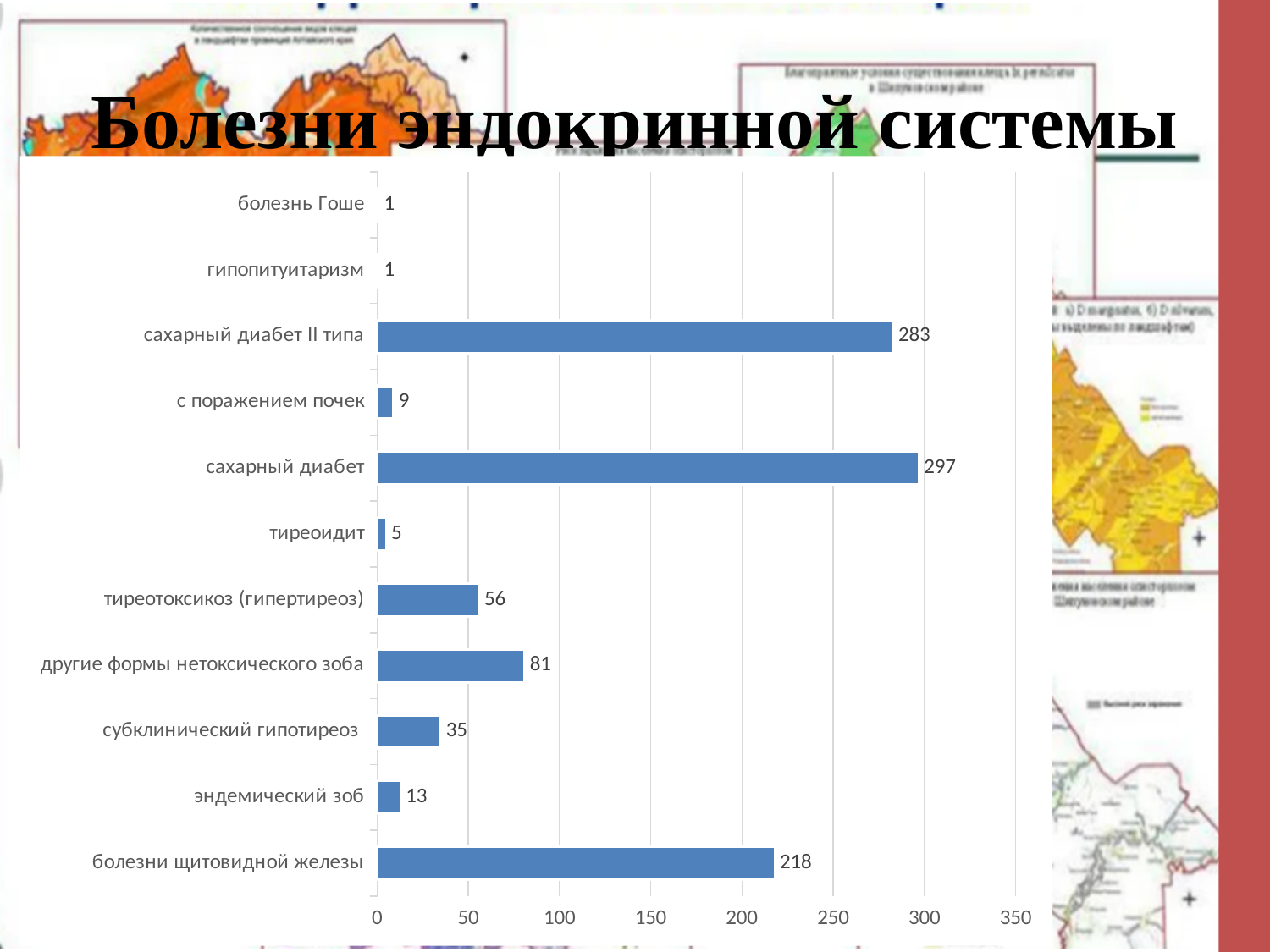
How many categories are shown in the chart? 11 What is the value for тиреотоксикоз (гипертиреоз)? 56 What is the difference between сахарный диабет and сахарный диабет II типа? 14 What is the value for болезни щитовидной железы? 218 What kind of chart is shown on the slide? bar chart Which is larger, тиреотоксикоз (гипертиреоз) or субклинический гипотиреоз? тиреотоксикоз (гипертиреоз) What is the value for эндемический зоб? 13 Which category has the highest value? сахарный диабет Is the value for болезни щитовидной железы greater or less than 200? greater What is the difference between другие формы нетоксического зоба and субклинический гипотиреоз? 46 What is the title of the slide? Болезни эндокринной системы What is the value for сахарный диабет? 297